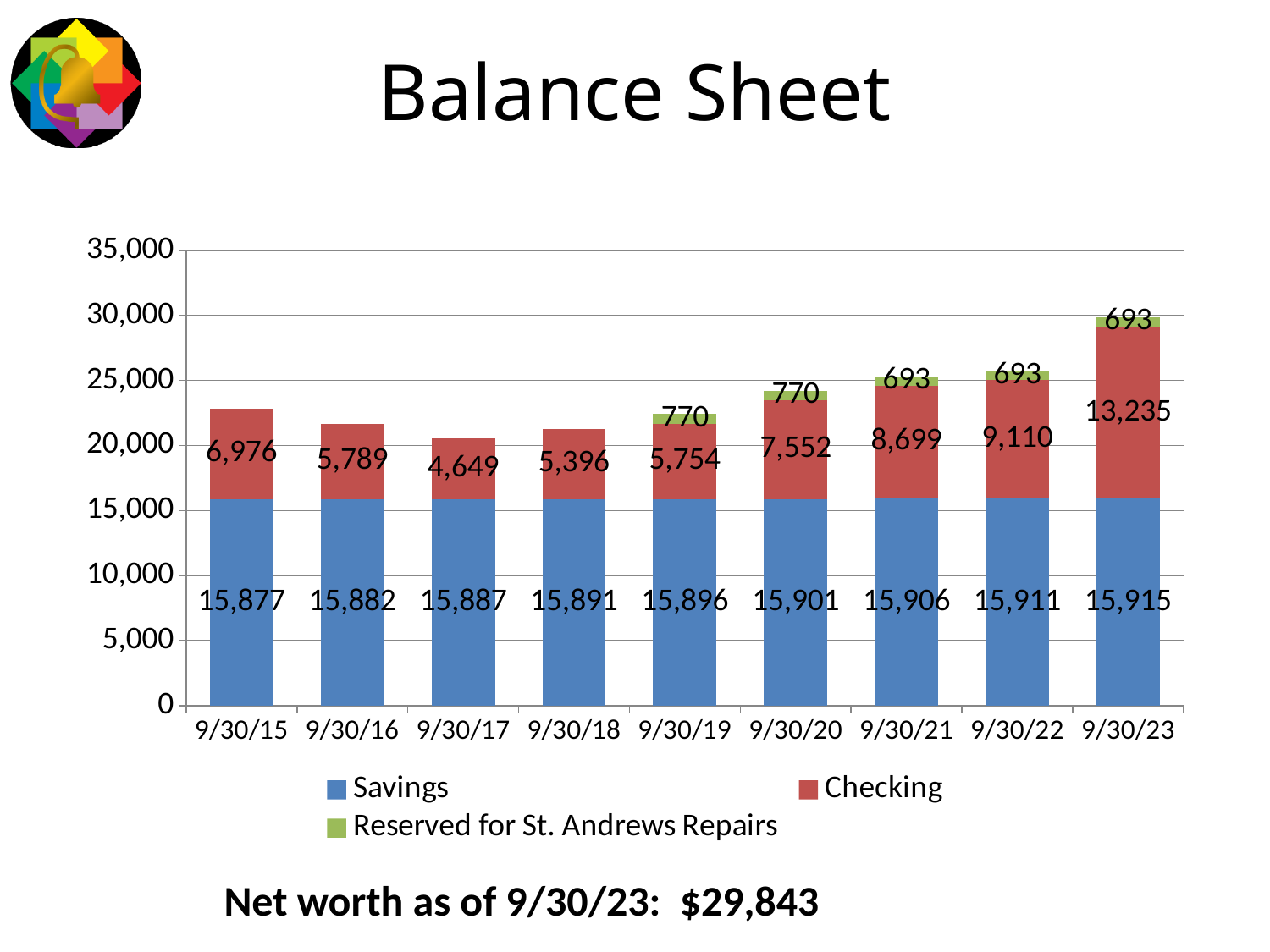
What is the Reserved for St. Andrews Repairs value for 9/30/20? 770 Which date has the lowest Checking value? 9/30/17 What is the difference between the Checking values for 9/30/23 and 9/30/22? 4,125 How many dates are shown on the x axis? 9 What is the Savings value for 9/30/15? 15,877 Is the Checking value larger for 9/30/15 or 9/30/16? 9/30/15 Which date has the highest Checking value? 9/30/23 What is the total of the stacked bar for 9/30/17? 20,536 What is the Checking value for 9/30/23? 13,235 What kind of chart is shown on the slide? Stacked bar chart How many series does the legend list? 3 What is the total of the stacked bar for 9/30/23? 29,843